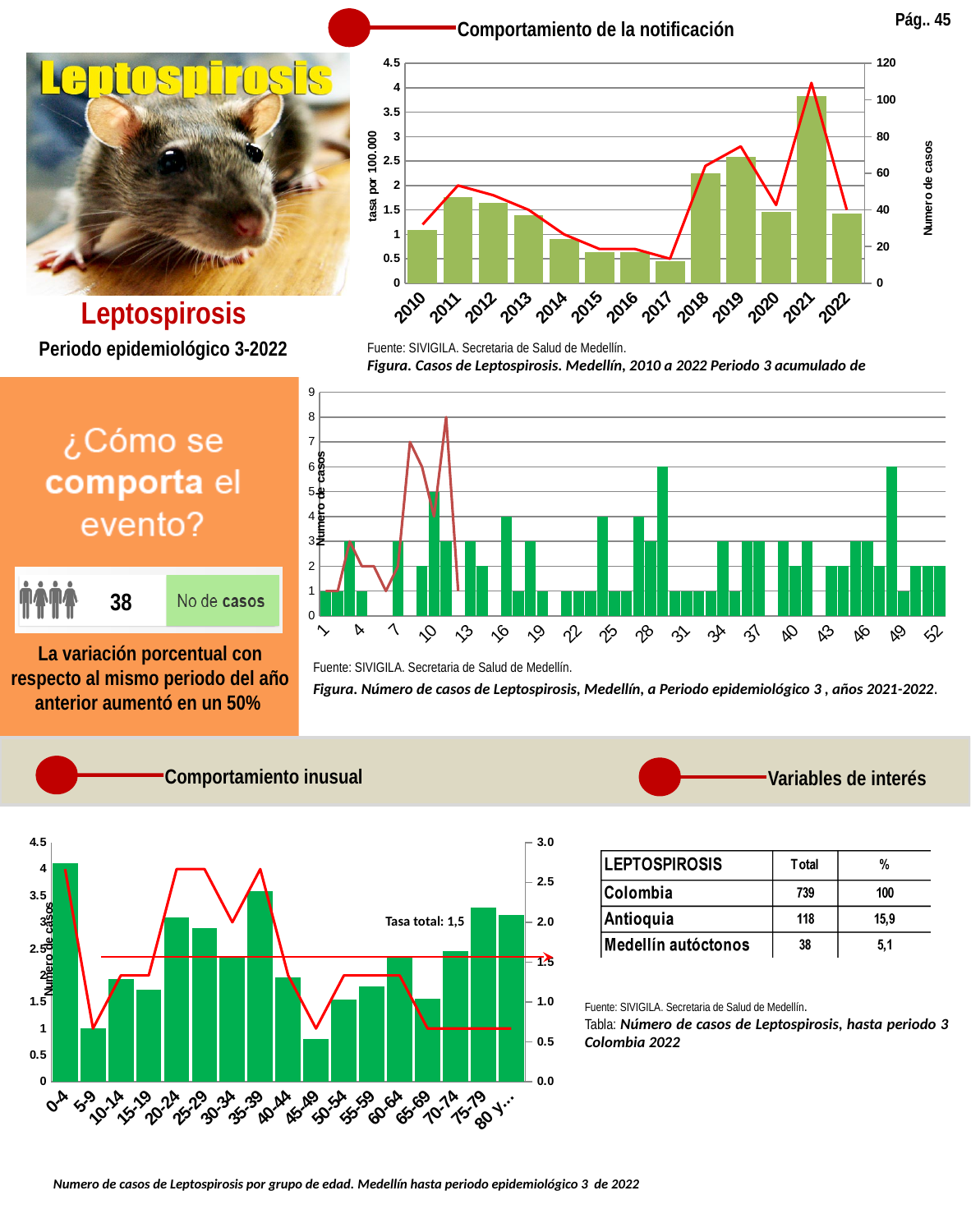
In the top-right chart (Casos de Leptospirosis, Medellín, 2010 a 2022), is the bar for 2018 greater or less than 2 on the left axis? greater In the top-right chart (Casos de Leptospirosis, Medellín, 2010 a 2022), is the bar for 2021 larger or smaller than the bar for 2019? larger In the middle chart (Número de casos de Leptospirosis, Medellín, años 2021-2022), what is the value of the green bar at week 29? 6 In the top-right chart (Casos de Leptospirosis, Medellín, 2010 a 2022), which year has the shortest bar? 2017 In the middle chart (Número de casos de Leptospirosis, Medellín, años 2021-2022), what is the highest value reached by the red line? 8 In the bottom-left chart (casos de Leptospirosis por grupo de edad), which age group has the shortest bar? 45-49 In the top-right chart (Casos de Leptospirosis, Medellín, 2010 a 2022), how many years are shown on the x axis? 13 In the top-right chart (Casos de Leptospirosis, Medellín, 2010 a 2022), what is the label of the left vertical axis? tasa por 100.000 In the top-right chart (Casos de Leptospirosis, Medellín, 2010 a 2022), which year has the tallest bar? 2021 In the bottom-left chart (casos de Leptospirosis por grupo de edad), which age group has the tallest bar? 0-4 In the middle chart (Número de casos de Leptospirosis, Medellín, años 2021-2022), is the green bar at week 16 greater or less than 3? greater